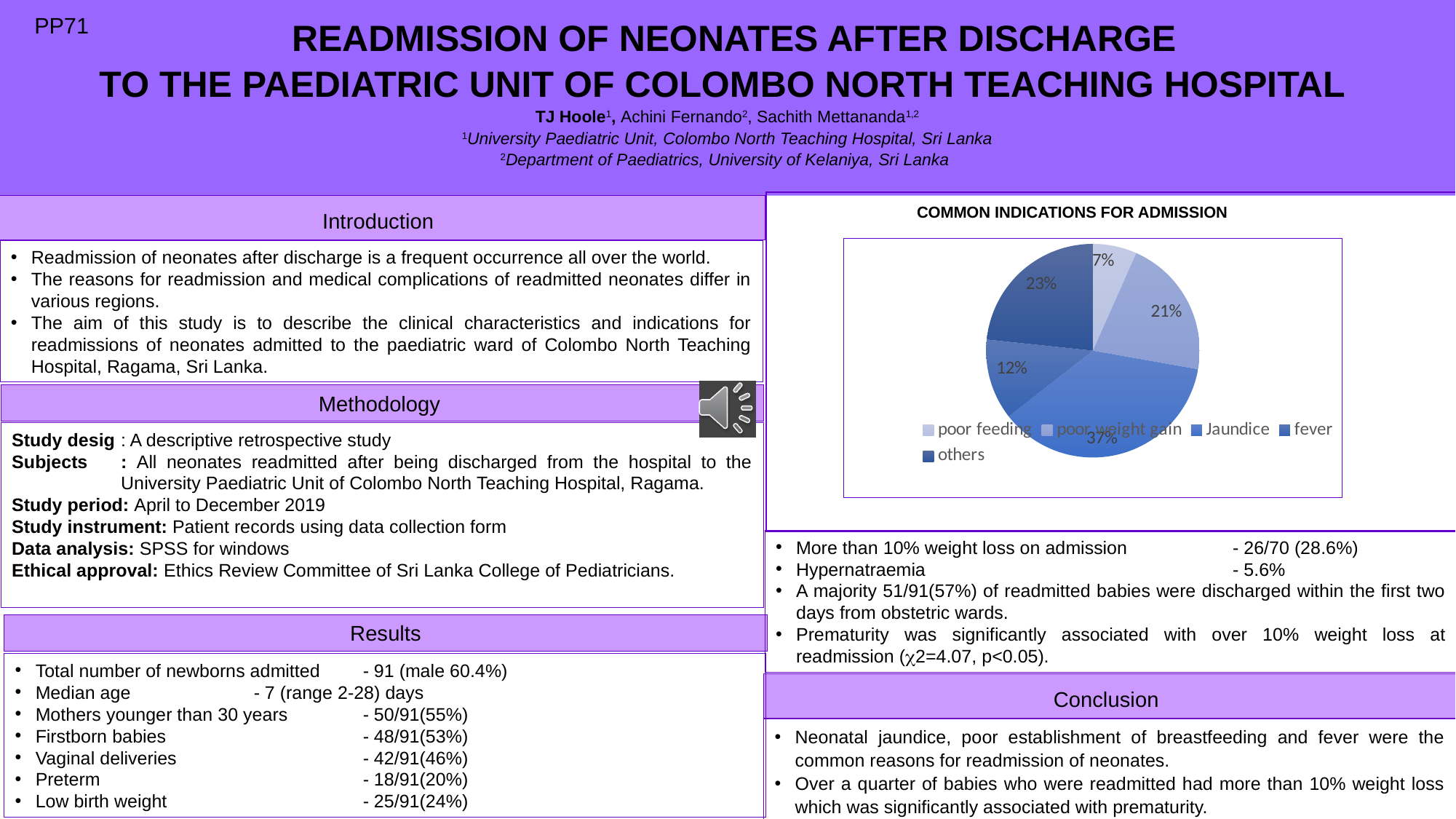
What share of the pie chart does Jaundice account for? 37% Which category has the largest slice in the pie chart? Jaundice Which legend entry in the pie chart is shown in the lightest shade of blue? poor feeding What percentage is shown for others in the pie chart? 23% Which category has the smallest slice in the pie chart? poor feeding How many categories does the legend of the pie chart list? 5 What is the title of the pie chart on the slide? COMMON INDICATIONS FOR ADMISSION In the pie chart, what is the difference in percentage points between Jaundice and others? 14 What percentage is shown for poor weight gain in the pie chart? 21% In the pie chart, which is larger: poor weight gain or fever? poor weight gain What percentage is shown for fever in the pie chart? 12% What type of chart is shown under the title "COMMON INDICATIONS FOR ADMISSION"? pie chart